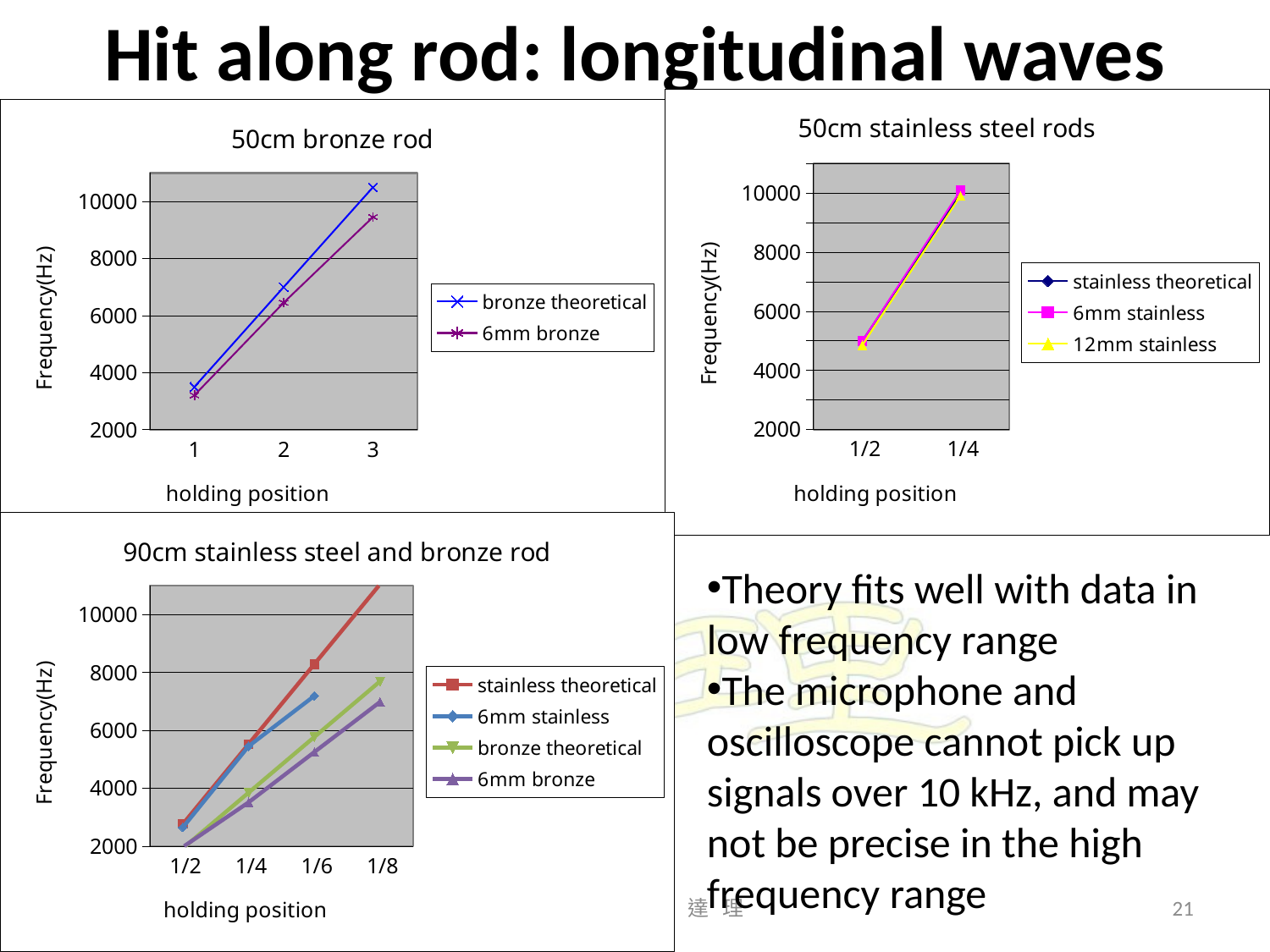
In the "90cm stainless steel and bronze rod" chart, is the value for 6mm bronze at holding position 1/8 greater or less than 8000? less In the "50cm bronze rod" chart, do the frequency values rise or fall as the holding position goes from 1 to 3? rise How many series does the legend of the "50cm stainless steel rods" chart list? 3 How many series does the legend of the "90cm stainless steel and bronze rod" chart list? 4 In the "50cm bronze rod" chart, is the value for 6mm bronze at holding position 1 greater or less than 4000? less In the "50cm stainless steel rods" chart, is the value for 6mm stainless at holding position 1/2 greater or less than 6000? less How many holding positions are plotted on the x axis of the "90cm stainless steel and bronze rod" chart? 4 What kind of chart is the "50cm bronze rod" chart? line chart In the "90cm stainless steel and bronze rod" chart, what colour is the stainless theoretical line? red In the "90cm stainless steel and bronze rod" chart, which is larger at holding position 1/6: 6mm stainless or 6mm bronze? 6mm stainless How many holding positions are plotted on the x axis of the "50cm stainless steel rods" chart? 2